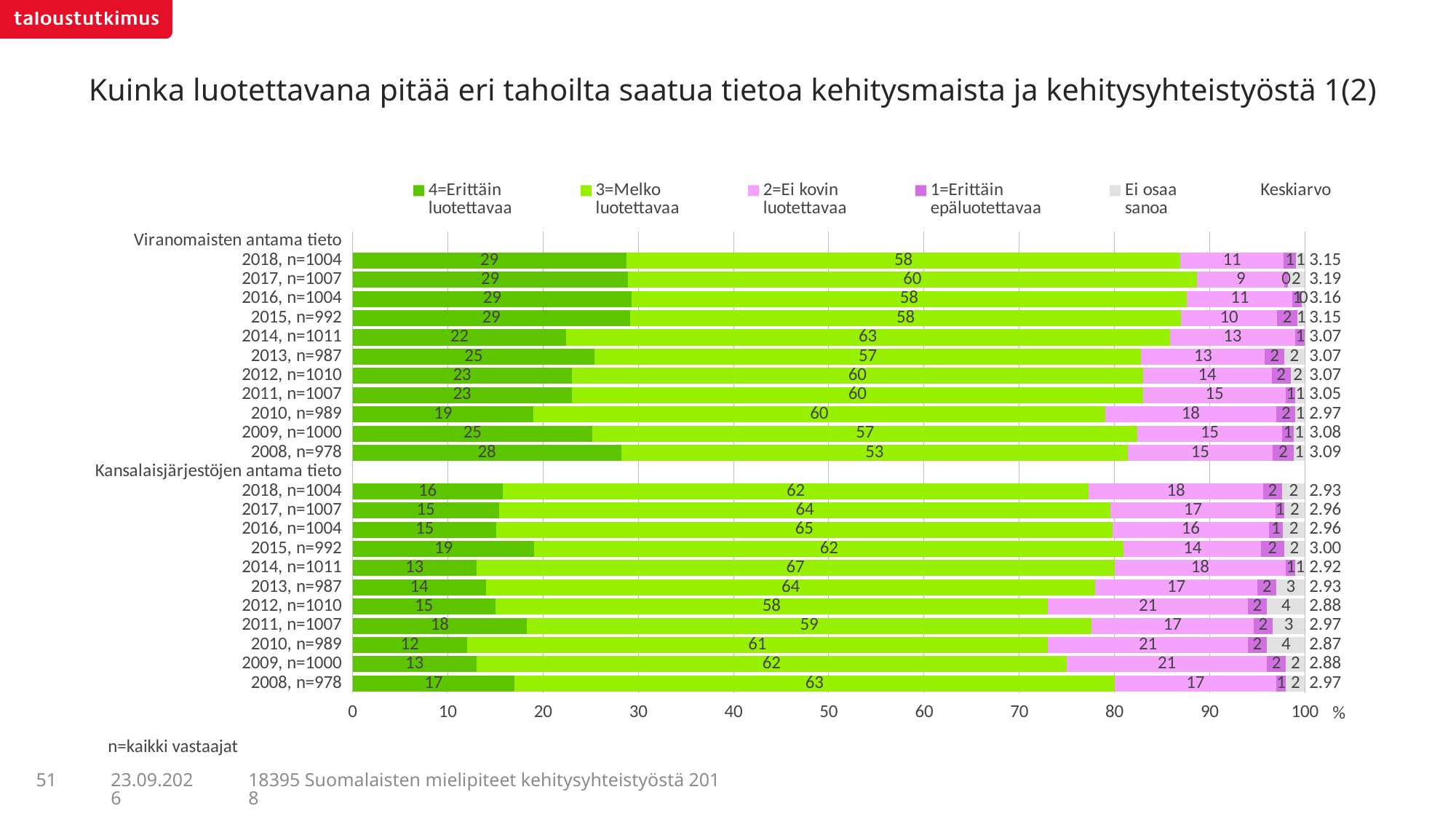
For 2012, which has the larger "2=Ei kovin luotettavaa" value: Viranomaisten antama tieto or Kansalaisjärjestöjen antama tieto? Kansalaisjärjestöjen antama tieto What kind of chart is shown on the slide? Stacked horizontal bar chart What is the difference between the "3=Melko luotettavaa" values for Viranomaisten antama tieto in 2014 (63) and 2018 (58)? 5 What is the Keskiarvo shown for Viranomaisten antama tieto in 2017, n=1007? 3.19 Among the Kansalaisjärjestöjen antama tieto bars, which year has the lowest Keskiarvo? 2010, n=989 What is the value for "4=Erittäin luotettavaa" in the Viranomaisten antama tieto bar for 2018, n=1004? 29 What is the value for "3=Melko luotettavaa" in the Kansalaisjärjestöjen antama tieto bar for 2014, n=1011? 67 What is the value for "Ei osaa sanoa" in the Kansalaisjärjestöjen antama tieto bar for 2010, n=989? 4 How many entries does the chart legend list? 6 What colour represents "4=Erittäin luotettavaa" in the chart? Dark green Among the Viranomaisten antama tieto bars, which year has the highest Keskiarvo? 2017, n=1007 How many bars are shown under the Viranomaisten antama tieto group? 11